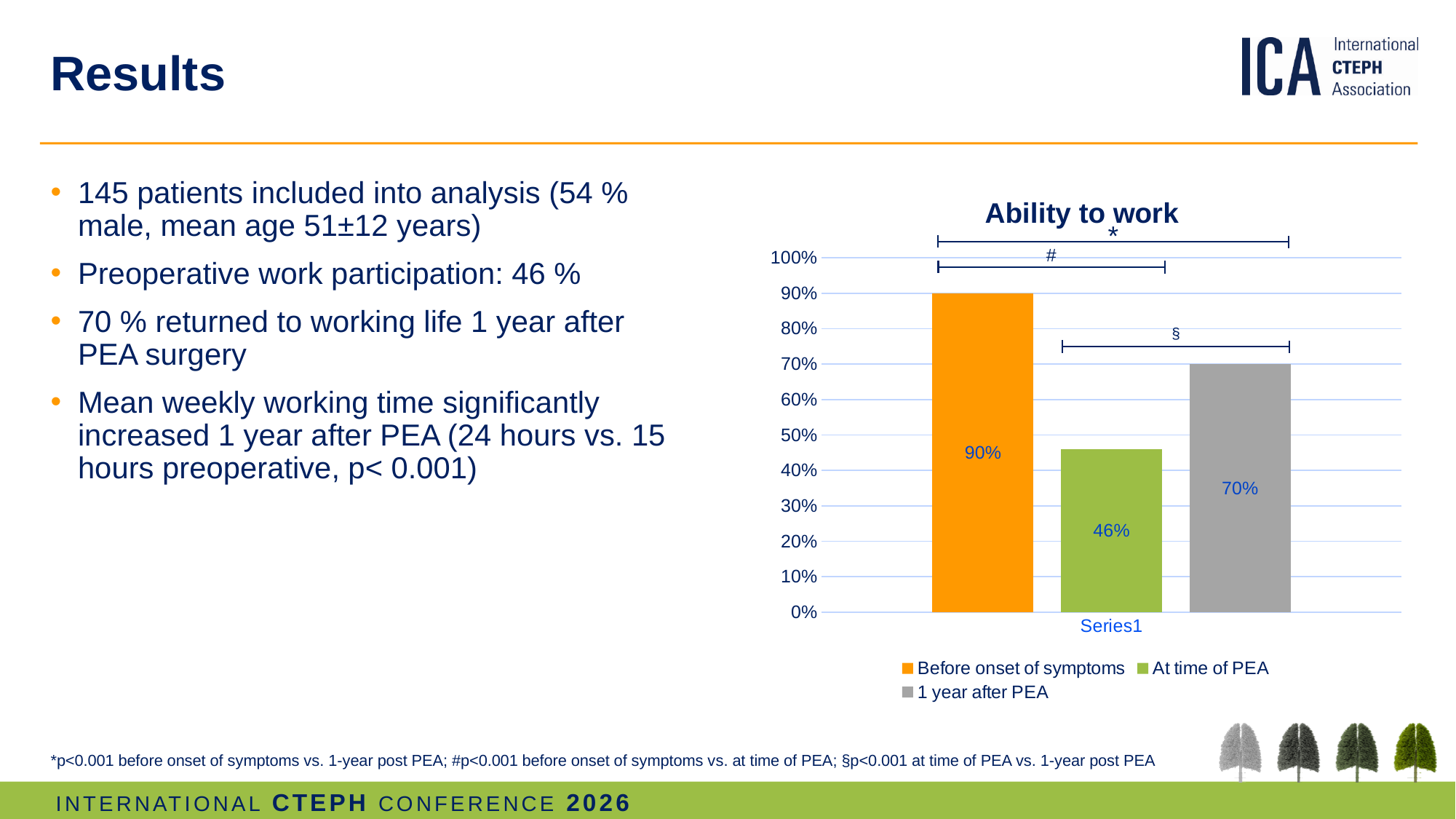
Which series has the highest value in the Ability to work chart? Before onset of symptoms What is the difference between the '1 year after PEA' and 'At time of PEA' values? 24% Which is larger: the value for 'At time of PEA' or for '1 year after PEA'? 1 year after PEA What is the value for 'Before onset of symptoms' in the Ability to work chart? 90% What kind of chart is shown on the slide? bar chart Is the value for 'At time of PEA' greater or less than 50%? less What is the difference between the 'Before onset of symptoms' and '1 year after PEA' values? 20% Which series has the lowest value in the Ability to work chart? At time of PEA How many series does the legend of the Ability to work chart list? 3 What is the value for '1 year after PEA' in the Ability to work chart? 70% What is the title of the chart on the slide? Ability to work What is the value for 'At time of PEA' in the Ability to work chart? 46%